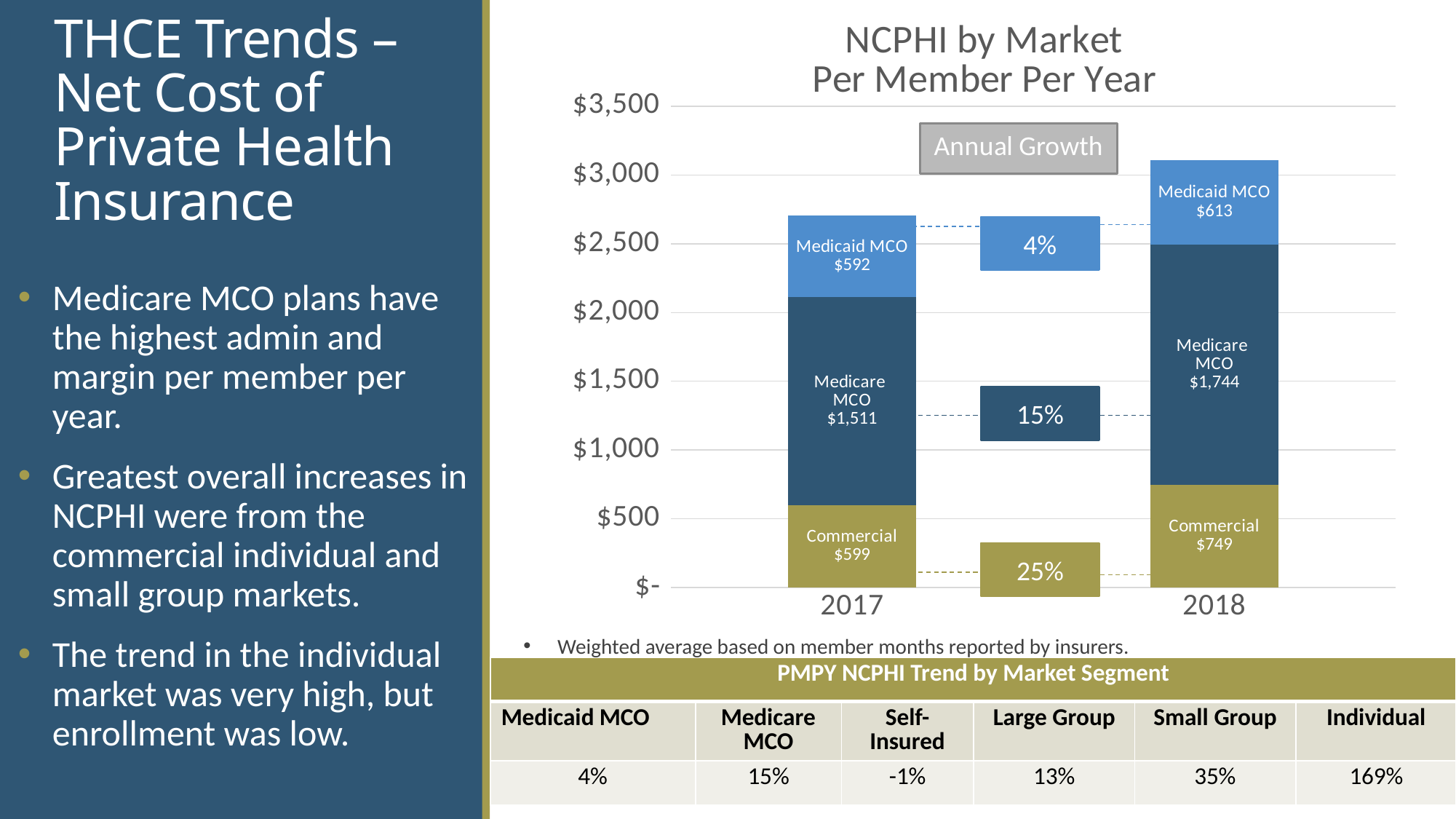
What is the Commercial value for 2018? $749 Which segment has the smallest value in 2017? Medicaid MCO By how much did the Commercial value increase from 2017 to 2018? $150 What is the difference between the Medicare MCO values for 2018 and 2017? $233 What annual growth percentage is shown for the Commercial segment? 25% What is the total of the stacked bar for 2018? $3,106 What is the Medicaid MCO value for 2018? $613 What type of chart is shown on the slide? Stacked bar chart Which is larger, the Medicaid MCO value in 2017 or the Commercial value in 2017? Commercial value in 2017 What is the total of the stacked bar for 2017? $2,702 What is the Medicare MCO value for 2017? $1,511 Which segment has the largest value in 2018? Medicare MCO